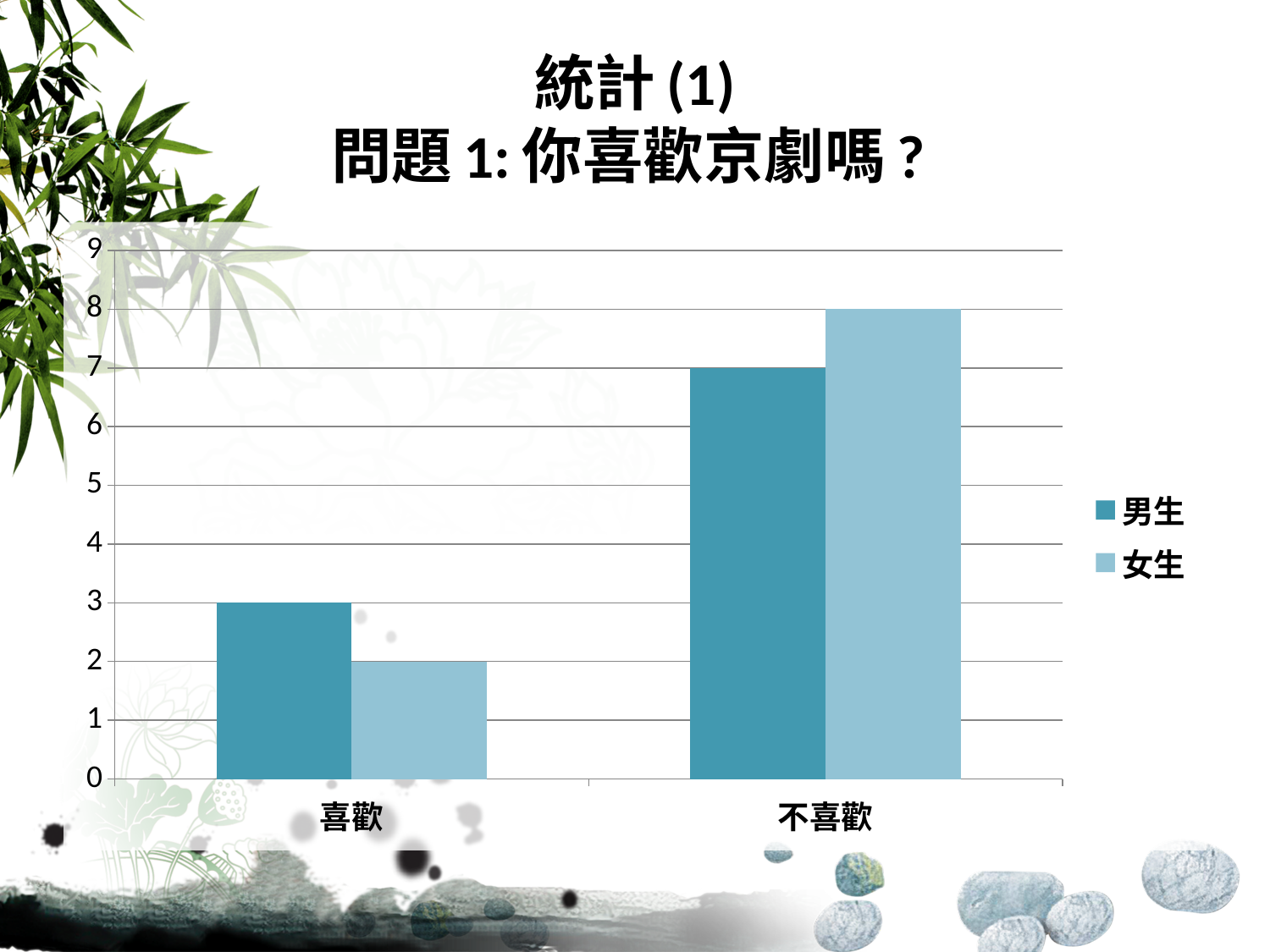
What is the value for 女生 in the 喜歡 category? 2 How many categories are shown on the x axis? 2 What is the value for 男生 in the 喜歡 category? 3 What is the difference between the 女生 and 男生 values in the 不喜歡 category? 1 What is the value for 女生 in the 不喜歡 category? 8 What kind of chart is shown on the slide? bar chart Which category has the highest value for 女生? 不喜歡 What is the value for 男生 in the 不喜歡 category? 7 In the 喜歡 category, which is larger, the value for 男生 or for 女生? 男生 Which category has the lowest value for 男生? 喜歡 Is the value for 男生 in the 不喜歡 category greater or less than 5? greater How many series does the legend list? 2